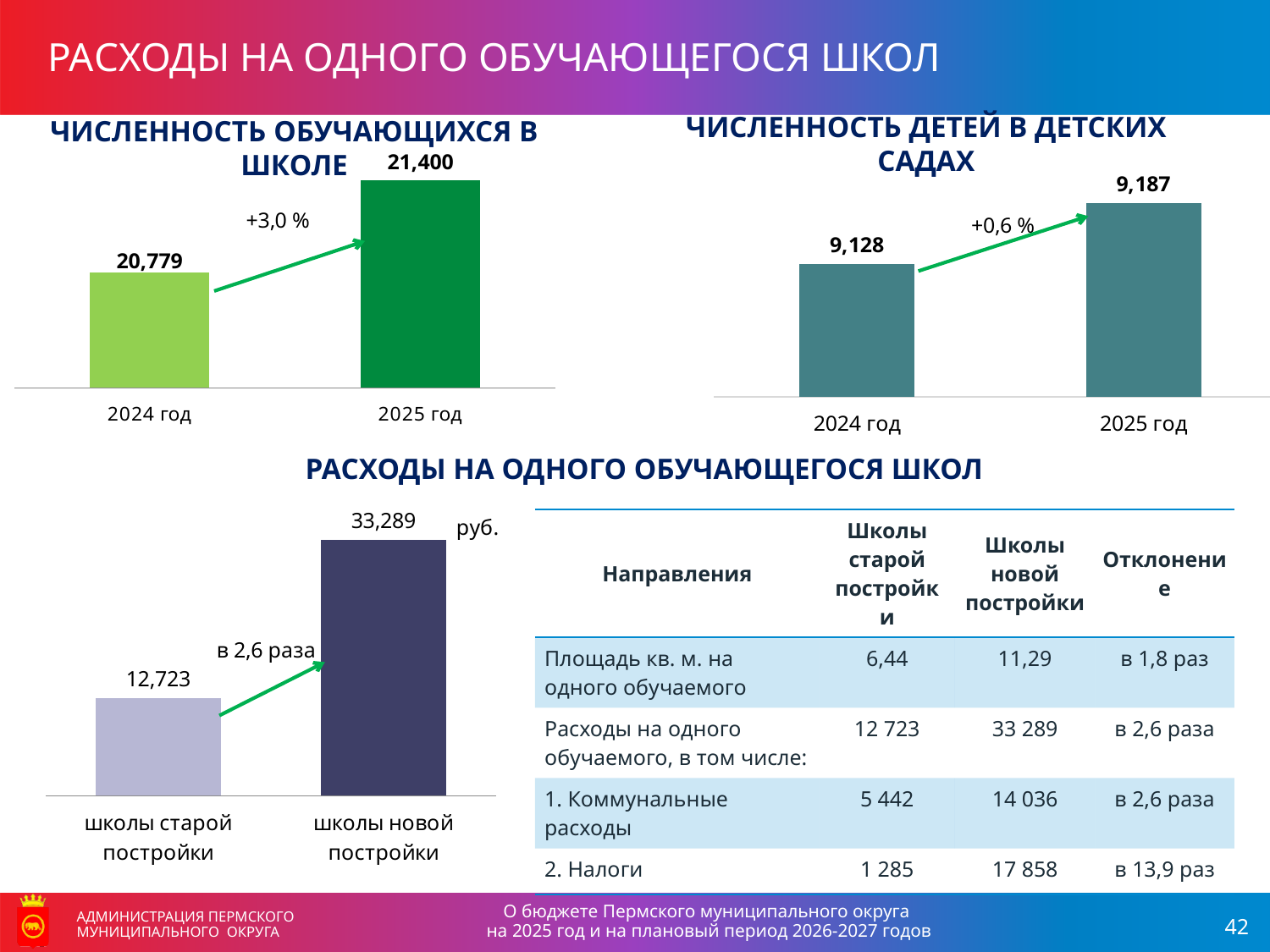
In the chart 'ЧИСЛЕННОСТЬ ОБУЧАЮЩИХСЯ В ШКОЛЕ', what is the difference between the 2025 год and 2024 год values? 621 In the chart 'ЧИСЛЕННОСТЬ ДЕТЕЙ В ДЕТСКИХ САДАХ', what is the value for 2025 год? 9,187 In the chart 'РАСХОДЫ НА ОДНОГО ОБУЧАЮЩЕГОСЯ ШКОЛ', what is the difference between школы новой постройки and школы старой постройки? 20,566 In the chart 'РАСХОДЫ НА ОДНОГО ОБУЧАЮЩЕГОСЯ ШКОЛ', what is the value for школы старой постройки? 12,723 In the chart 'ЧИСЛЕННОСТЬ ДЕТЕЙ В ДЕТСКИХ САДАХ', which year has the higher value? 2025 год In the chart 'РАСХОДЫ НА ОДНОГО ОБУЧАЮЩЕГОСЯ ШКОЛ', what is the value for школы новой постройки? 33,289 In the chart 'ЧИСЛЕННОСТЬ ДЕТЕЙ В ДЕТСКИХ САДАХ', what is the difference between the 2025 год and 2024 год values? 59 What kind of chart is 'РАСХОДЫ НА ОДНОГО ОБУЧАЮЩЕГОСЯ ШКОЛ'? bar chart In the chart 'ЧИСЛЕННОСТЬ ОБУЧАЮЩИХСЯ В ШКОЛЕ', what is the value for 2025 год? 21,400 In the chart 'ЧИСЛЕННОСТЬ ОБУЧАЮЩИХСЯ В ШКОЛЕ', what is the value for 2024 год? 20,779 In the chart 'ЧИСЛЕННОСТЬ ДЕТЕЙ В ДЕТСКИХ САДАХ', what is the value for 2024 год? 9,128 In the chart 'ЧИСЛЕННОСТЬ ОБУЧАЮЩИХСЯ В ШКОЛЕ', what percentage change is shown between 2024 год and 2025 год? +3,0 %